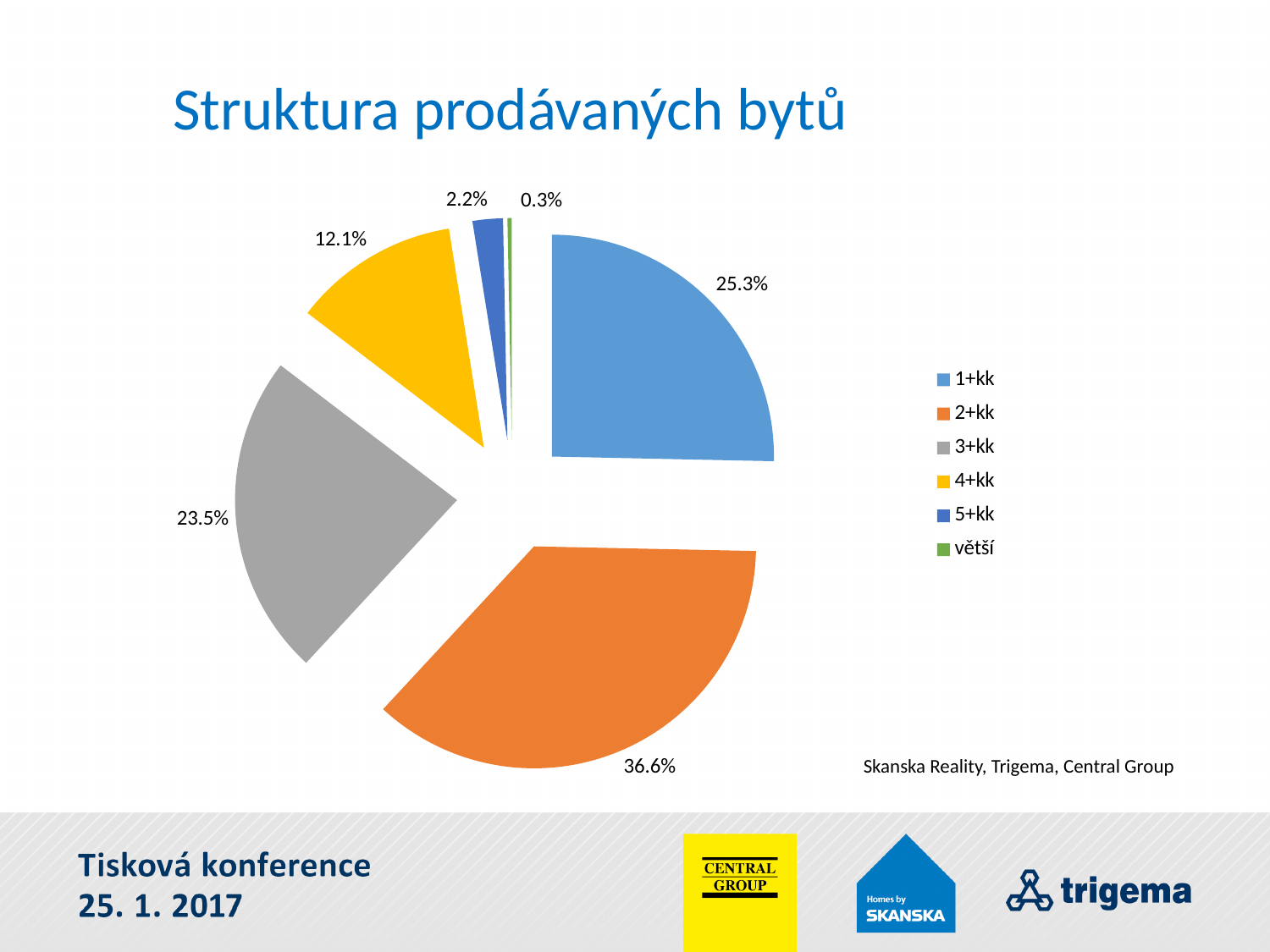
What share of the pie does the 2+kk slice represent? 36.6% What share of the pie does the 3+kk slice represent? 23.5% Which is larger, the share for 3+kk or the share for 4+kk? 3+kk What share of the pie does the 'větší' slice represent? 0.3% How many categories does the legend list? 6 What is the difference in percentage points between the 2+kk and 1+kk shares? 11.3 Which category has the largest share of the pie? 2+kk What kind of chart is shown on the slide? pie chart Which category has the smallest share of the pie? větší